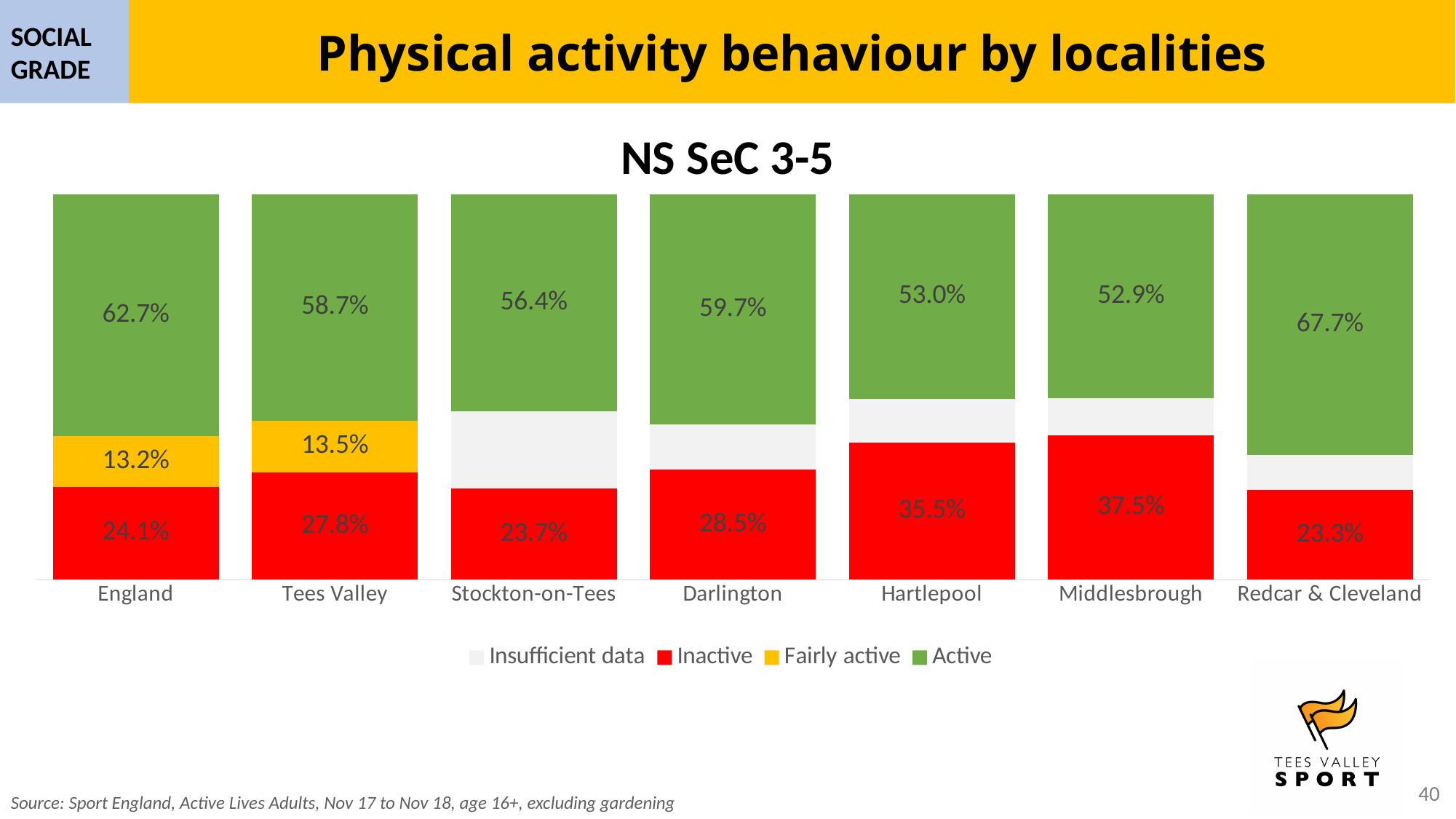
How many series does the legend list? 4 What is the title of the chart? NS SeC 3-5 What is the difference in Active percentage between England and Tees Valley? 4.0 percentage points Which locality has the highest Active percentage? Redcar & Cleveland What is the Inactive percentage for Hartlepool? 35.5% Which locality has the highest Inactive percentage? Middlesbrough What is the Fairly active percentage for Tees Valley? 13.5% How many localities are shown on the x axis? 7 What is the difference in Inactive percentage between Middlesbrough and Hartlepool? 2.0 percentage points What kind of chart is shown? Stacked bar chart What is the Active percentage for Redcar & Cleveland? 67.7% Which has a higher Active percentage, Darlington or Stockton-on-Tees? Darlington